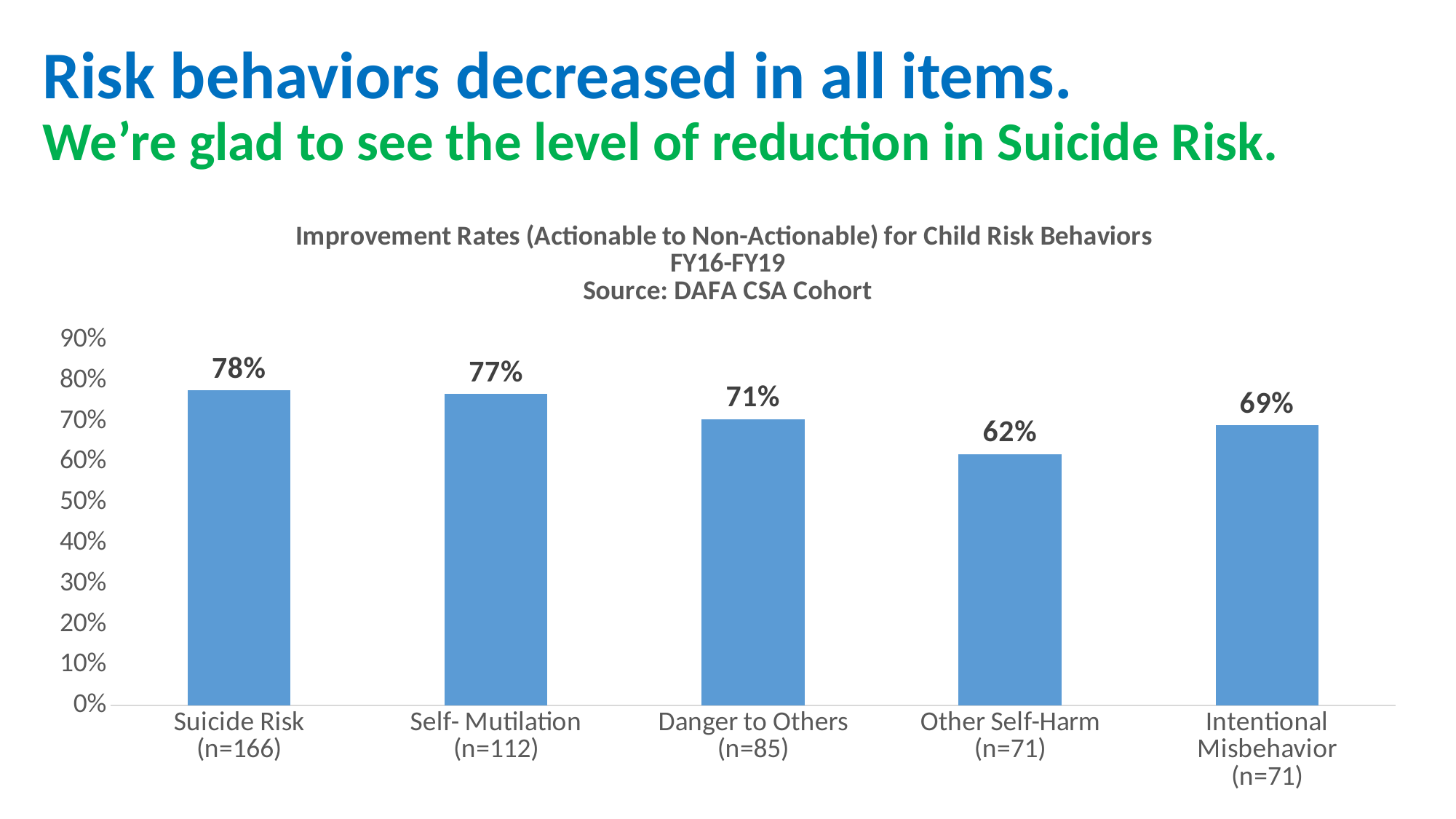
Which category has the lowest improvement rate? Other Self-Harm What is the difference between the improvement rates for Suicide Risk and Other Self-Harm? 16% What is the improvement rate for Other Self-Harm? 62% Which has a higher improvement rate, Danger to Others or Intentional Misbehavior? Danger to Others What kind of chart is shown on the slide? Bar chart What is the sample size (n) shown for Danger to Others? n=85 What is the difference between the improvement rates for Self- Mutilation and Danger to Others? 6% What is the improvement rate for Suicide Risk? 78% Is the value for Other Self-Harm greater or less than 70%? less What is the improvement rate for Intentional Misbehavior? 69% Which category has the highest improvement rate? Suicide Risk How many categories are shown in the chart? 5